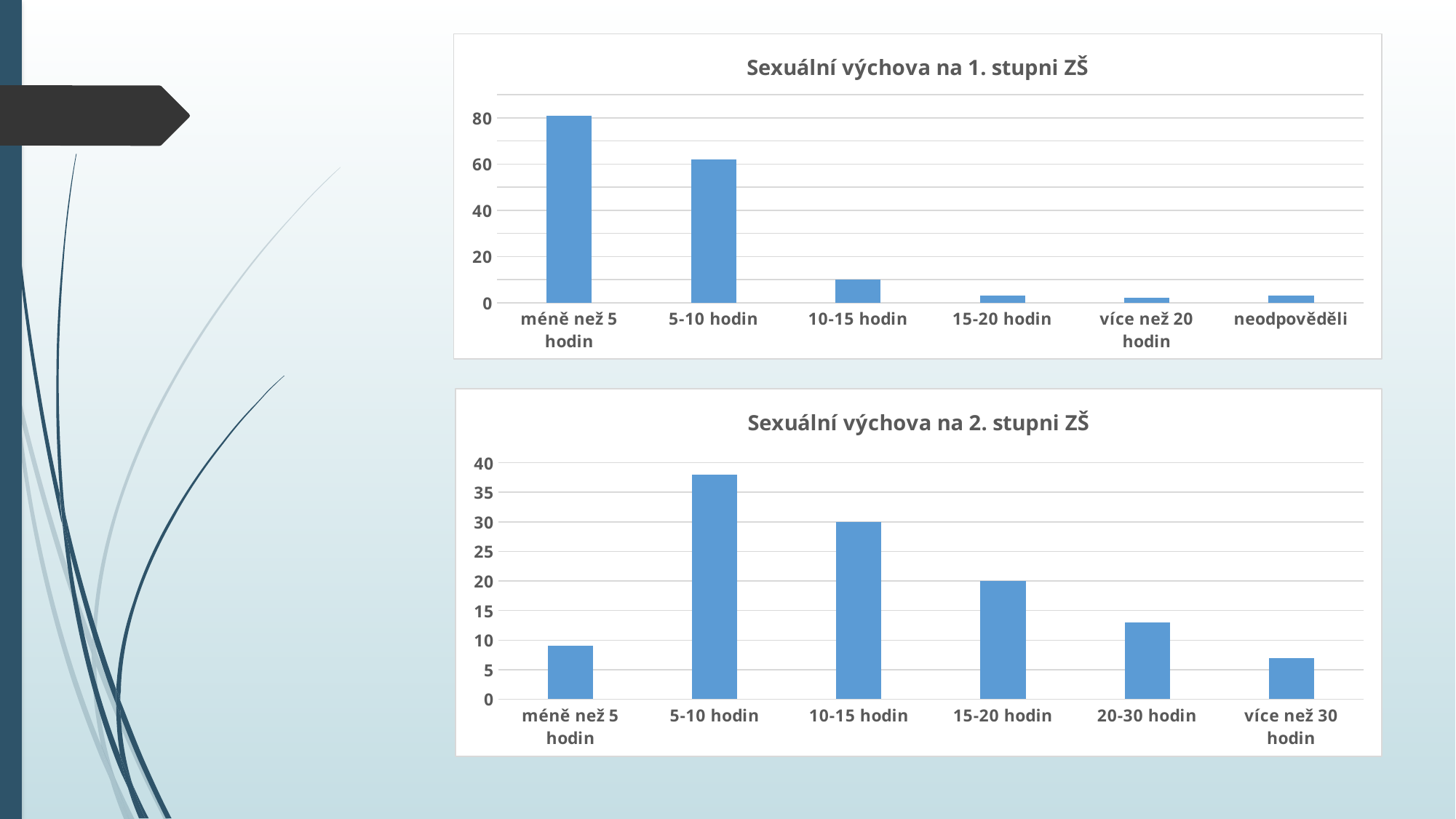
In the chart "Sexuální výchova na 2. stupni ZŠ", what is the value for "10-15 hodin"? 30 In the chart "Sexuální výchova na 2. stupni ZŠ", what is the value for "15-20 hodin"? 20 In the chart "Sexuální výchova na 1. stupni ZŠ", which category has the highest value? méně než 5 hodin What type of chart is "Sexuální výchova na 1. stupni ZŠ"? bar chart In the chart "Sexuální výchova na 1. stupni ZŠ", which is larger, the value for "5-10 hodin" or the value for "10-15 hodin"? 5-10 hodin In the chart "Sexuální výchova na 2. stupni ZŠ", which category has the highest value? 5-10 hodin In the chart "Sexuální výchova na 2. stupni ZŠ", is the value for "5-10 hodin" greater or less than 35? greater In the chart "Sexuální výchova na 1. stupni ZŠ", how many categories are shown on the x axis? 6 In the chart "Sexuální výchova na 2. stupni ZŠ", what is the difference between the values for "10-15 hodin" and "15-20 hodin"? 10 In the chart "Sexuální výchova na 1. stupni ZŠ", is the value for "5-10 hodin" greater or less than 60? greater In the chart "Sexuální výchova na 2. stupni ZŠ", which is larger, the value for "méně než 5 hodin" or the value for "20-30 hodin"? 20-30 hodin